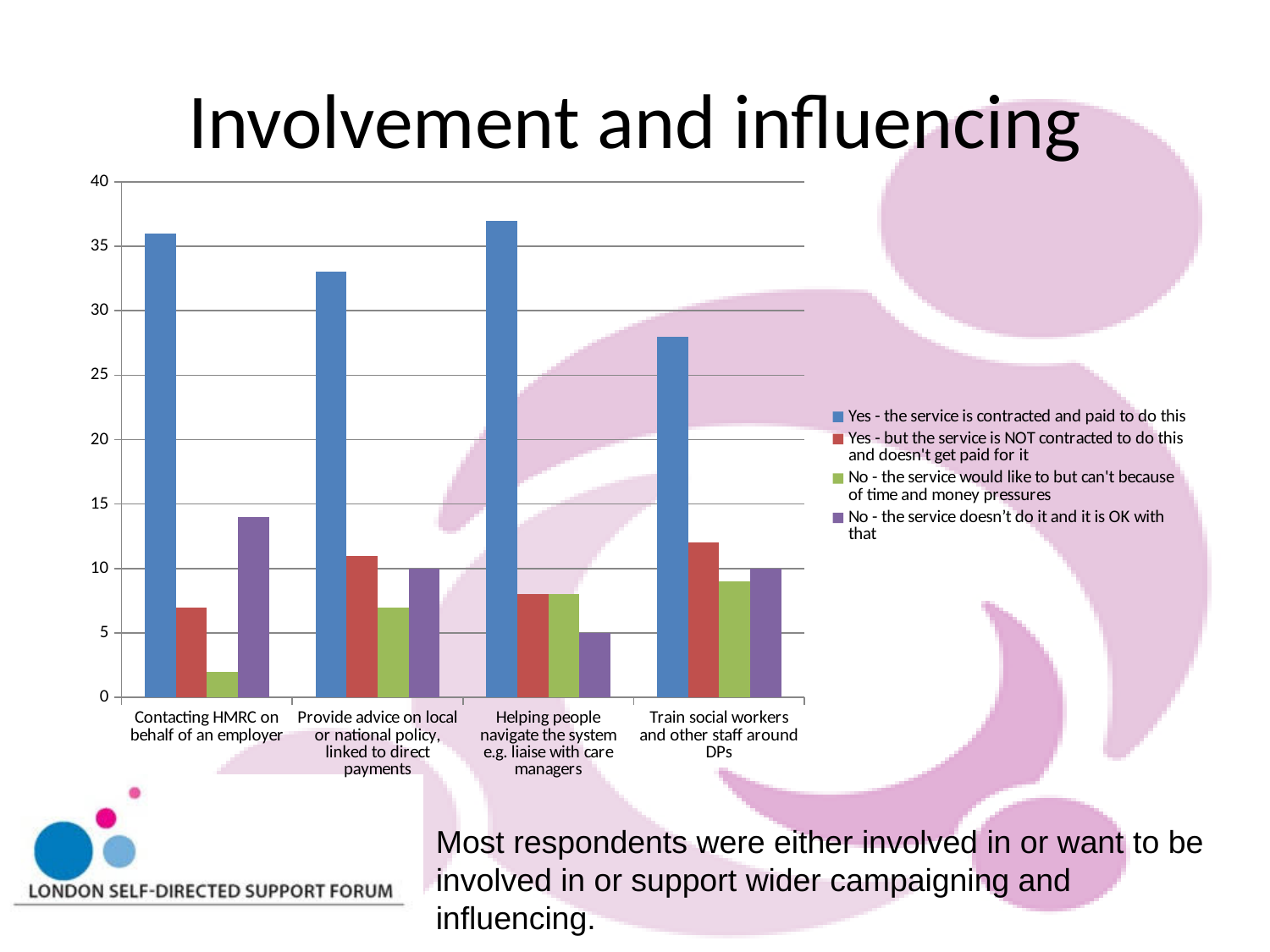
How many categories are shown on the x axis? 4 For 'Train social workers and other staff around DPs', which is larger: 'Yes - the service is contracted and paid to do this' or 'Yes - but the service is NOT contracted to do this and doesn't get paid for it'? Yes - the service is contracted and paid to do this Is the value for 'Yes - the service is contracted and paid to do this' in 'Train social workers and other staff around DPs' greater or less than 30? less Is the value for 'No - the service doesn't do it and it is OK with that' in 'Contacting HMRC on behalf of an employer' greater or less than 10? greater Which category has the lowest value for 'No - the service would like to but can't because of time and money pressures'? Contacting HMRC on behalf of an employer Which category has the highest value for 'No - the service doesn't do it and it is OK with that'? Contacting HMRC on behalf of an employer Which category has the highest value for 'Yes - the service is contracted and paid to do this'? Helping people navigate the system e.g. liaise with care managers How many series does the legend list? 4 Is the value for 'Yes - the service is contracted and paid to do this' in 'Contacting HMRC on behalf of an employer' greater or less than 35? greater What is the title of the slide containing the chart? Involvement and influencing Which category has the lowest value for 'Yes - the service is contracted and paid to do this'? Train social workers and other staff around DPs What kind of chart is shown on the slide? bar chart